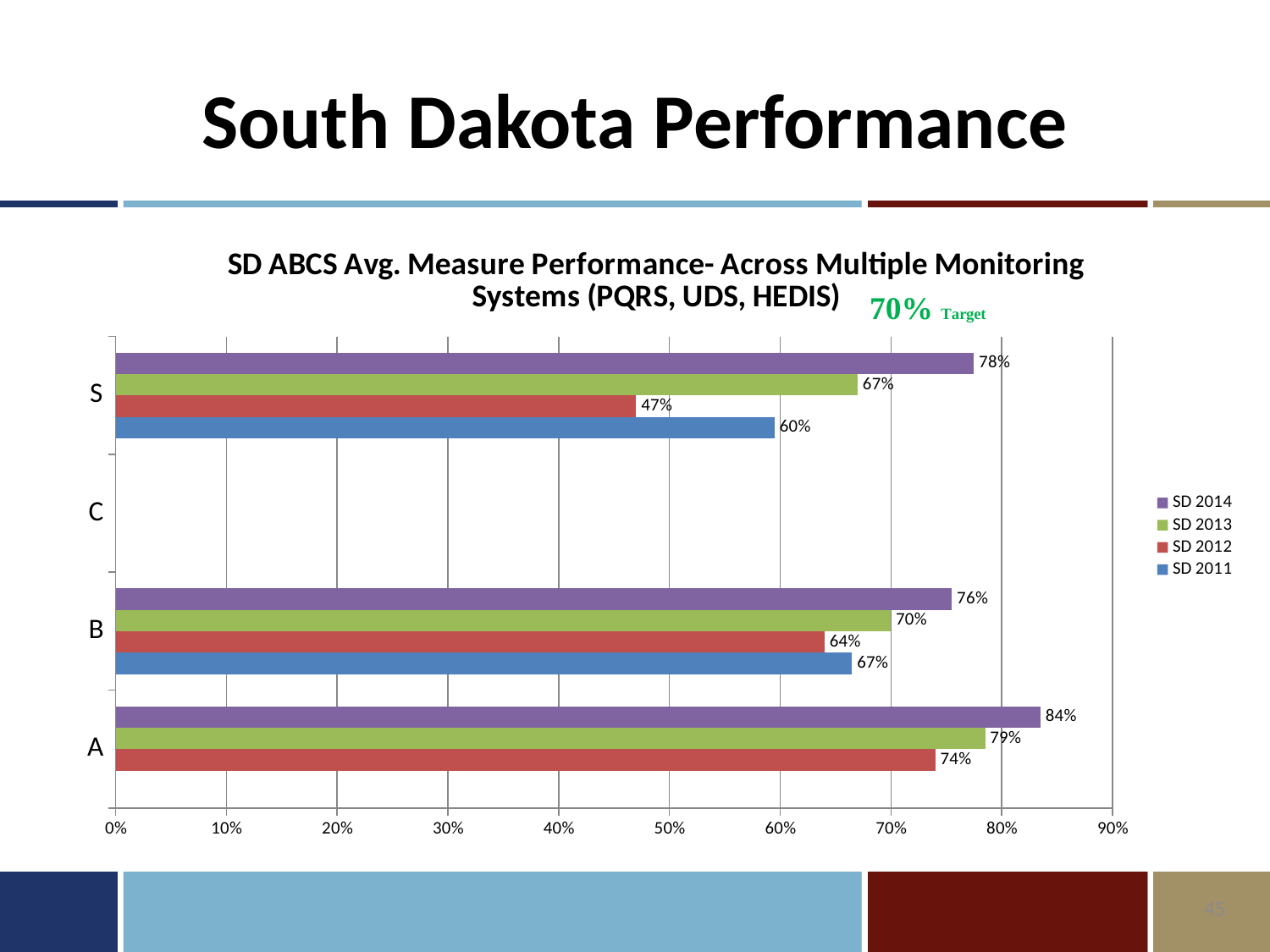
What is the SD 2011 value for category S? 60% Which is larger for category B: the SD 2011 value or the SD 2012 value? SD 2011 Which category has no bars plotted? C Which category has the lowest SD 2012 value? S What is the SD 2012 value for category B? 64% What is the difference between the SD 2014 and SD 2012 values for category S? 31% What kind of chart is shown on the slide? Bar chart What is the SD 2013 value for category A? 79% What target percentage is shown above the chart? 70% What is the SD 2014 value for category S? 78% Which category has the highest SD 2014 value? A How many series does the legend list? 4